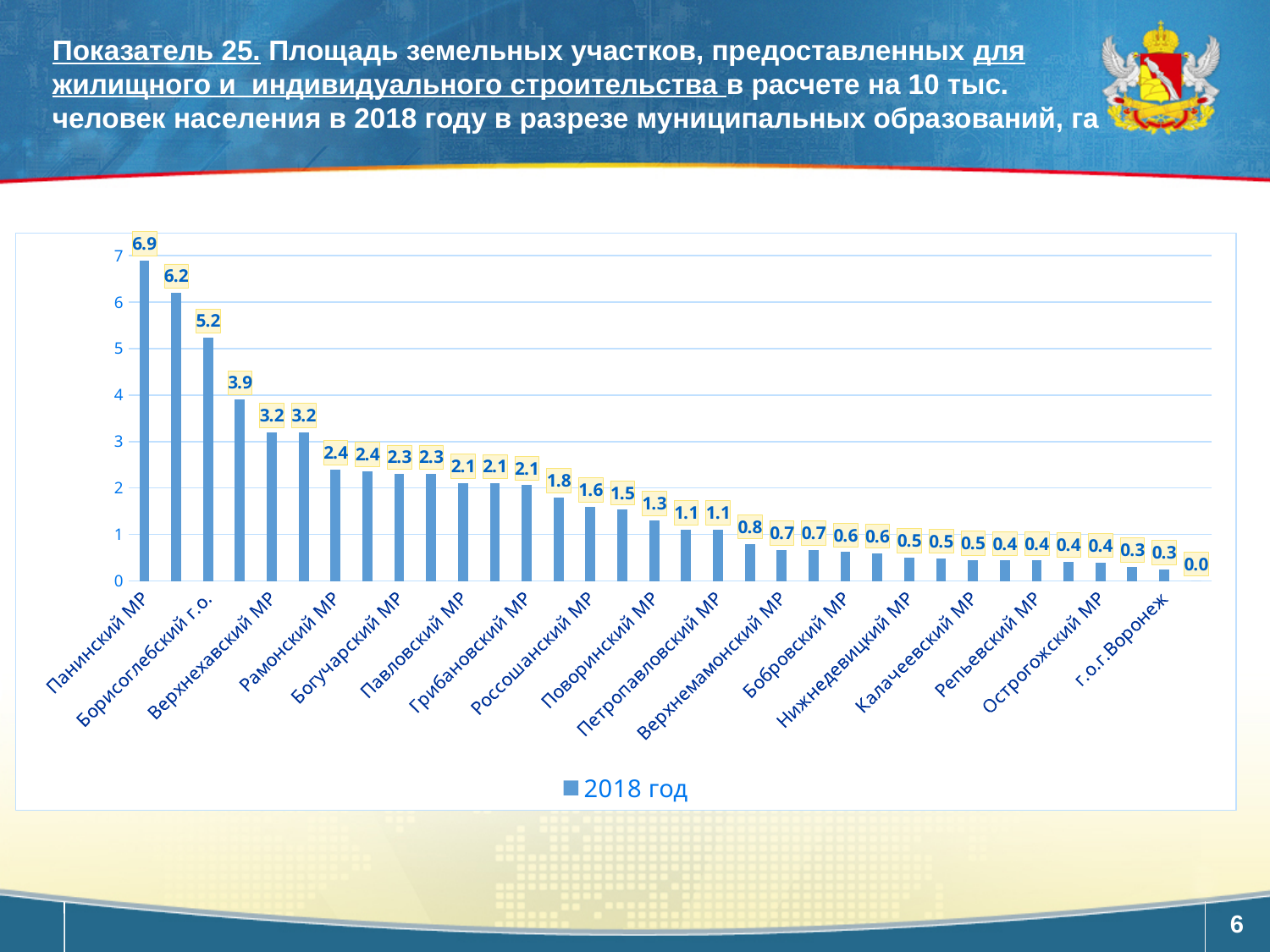
What is the value for Борисоглебский г.о.? 5.2 What kind of chart is shown on the slide? bar chart What is the value for Панинский МР? 6.9 What is the value for Рамонский МР? 2.4 What is the value for Верхнехавский МР? 3.2 What is the value for Поворинский МР? 1.3 Which is larger, the value for Верхнехавский МР or the value for Рамонский МР? Верхнехавский МР What is the only legend entry of the chart? 2018 год What is the difference between the values for Панинский МР and Борисоглебский г.о.? 1.7 Which municipality has the highest value? Панинский МР What is the value for Россошанский МР? 1.6 Is the value for Богучарский МР greater or less than 3? less